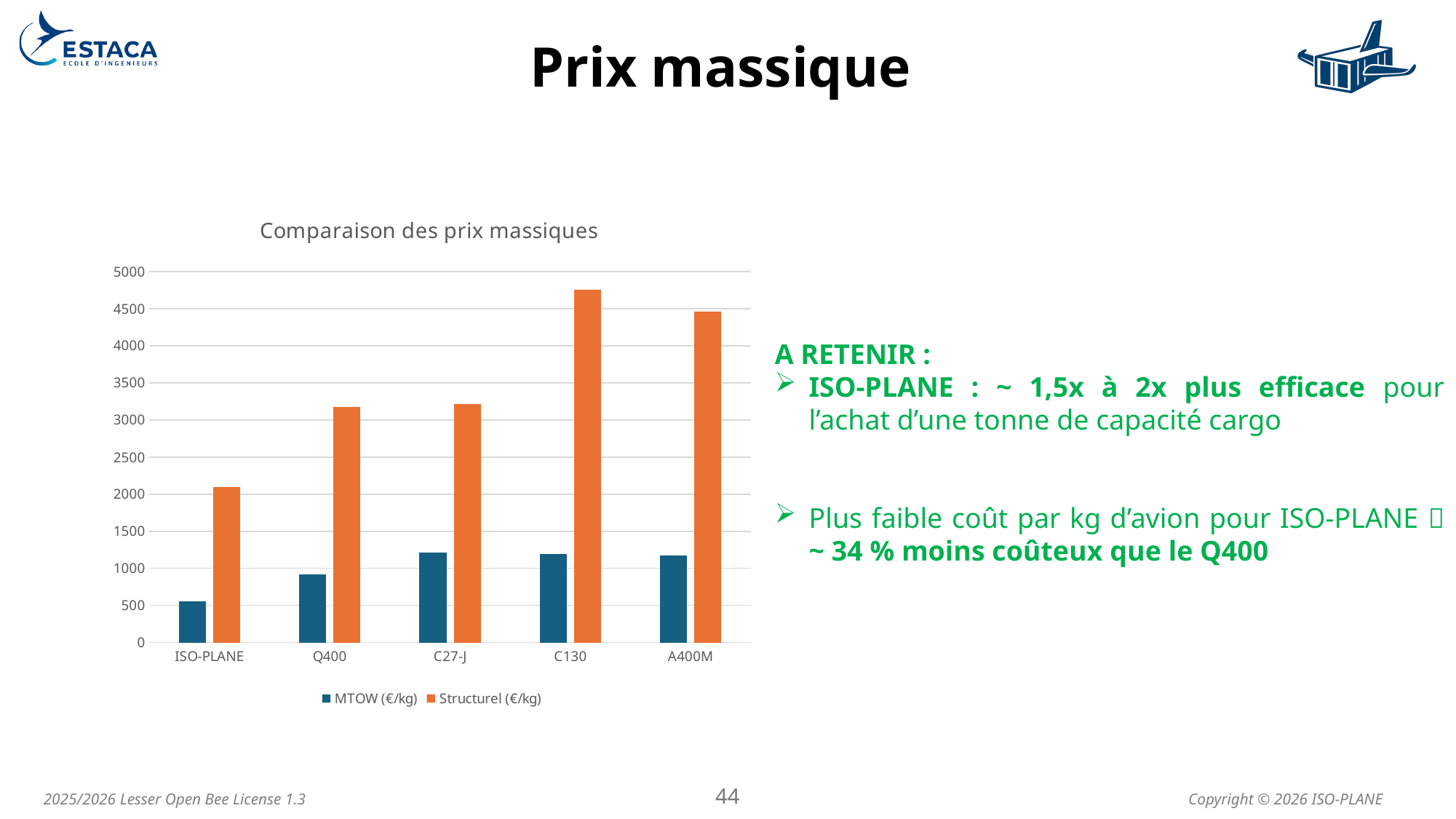
What is the title of the chart? Comparaison des prix massiques Which is larger, the Structurel (€/kg) value for ISO-PLANE or for Q400? Q400 Which aircraft has the lowest MTOW (€/kg) value? ISO-PLANE How many aircraft categories are shown on the x axis? 5 Which aircraft has the highest Structurel (€/kg) value? C130 Which series is shown in orange in the legend? Structurel (€/kg) What kind of chart is shown on the slide? bar chart Is the Structurel (€/kg) value for Q400 greater or less than 3000? greater How many series does the legend list? 2 Which aircraft has the lowest Structurel (€/kg) value? ISO-PLANE Is the MTOW (€/kg) value for Q400 greater or less than 1000? less Is the Structurel (€/kg) value for C130 greater or less than 4500? greater